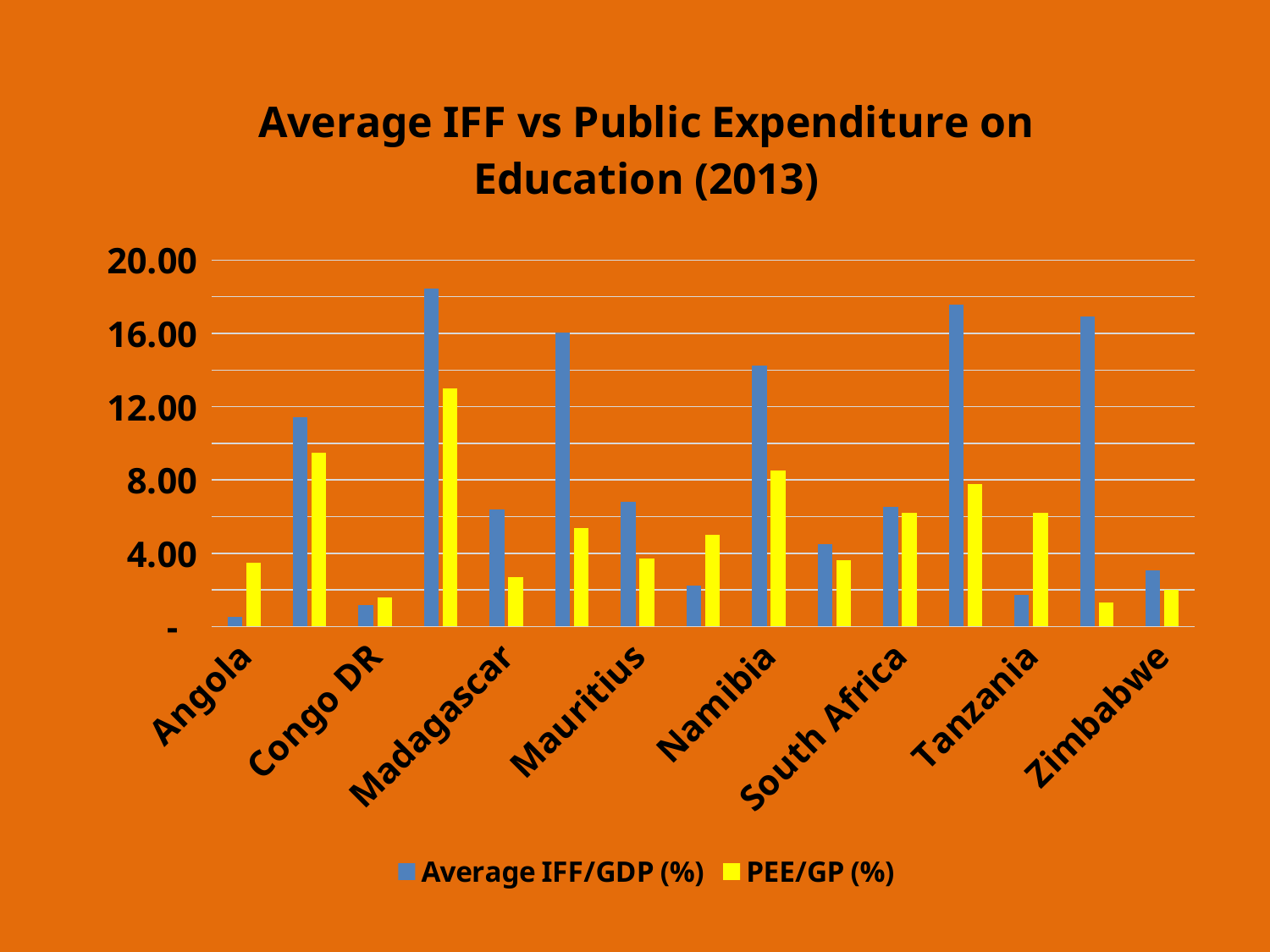
Is the Average IFF/GDP (%) value for Angola greater or less than 4.00? less What are the two series named in the legend? Average IFF/GDP (%) and PEE/GP (%) What kind of chart is shown on the slide? bar chart Is the Average IFF/GDP (%) value for Mauritius greater or less than 4.00? greater What is the title of the chart? Average IFF vs Public Expenditure on Education (2013) Is the PEE/GP (%) value for Mauritius greater or less than 8.00? less For Angola, which is larger: Average IFF/GDP (%) or PEE/GP (%)? PEE/GP (%) How many series does the legend list? 2